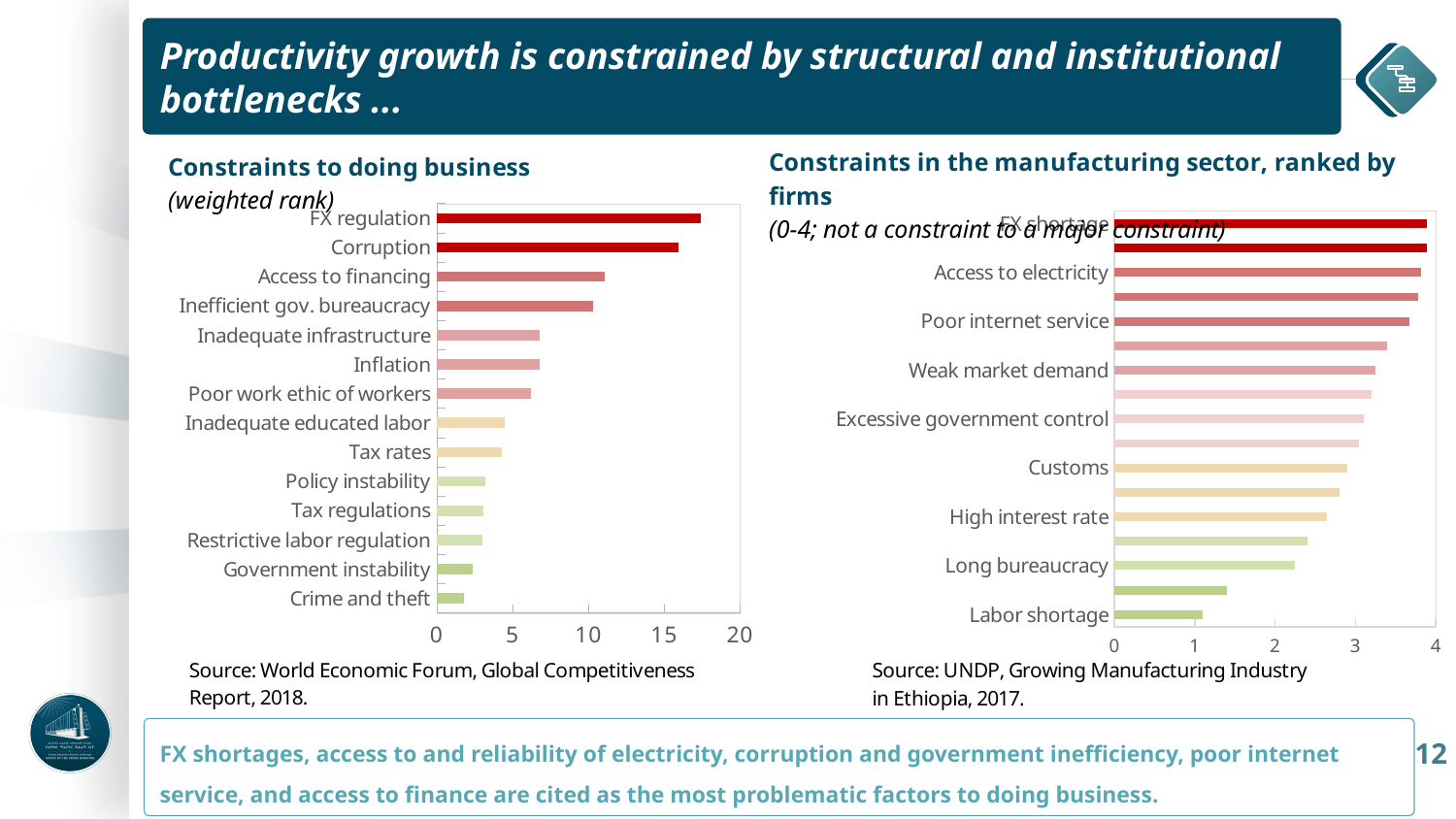
In the 'Constraints to doing business' chart, which category has the highest value? FX regulation In the 'Constraints in the manufacturing sector' chart, is the value for Weak market demand greater or less than 3? greater In the 'Constraints to doing business' chart, which category has the lowest value? Crime and theft What kind of chart is the 'Constraints to doing business' chart on the left? bar chart How many categories are shown in the 'Constraints to doing business' chart? 14 In the 'Constraints in the manufacturing sector' chart, is the value for Labor shortage greater or less than 2? less In the 'Constraints to doing business' chart, is the value for Inadequate infrastructure greater or less than 10? less What is the source cited for the 'Constraints to doing business' chart? World Economic Forum, Global Competitiveness Report, 2018 In the 'Constraints in the manufacturing sector' chart, which labelled category has the highest value? FX shortage In the 'Constraints in the manufacturing sector' chart, which labelled category has the lowest value? Labor shortage In the 'Constraints to doing business' chart, which is larger: Corruption or Access to financing? Corruption